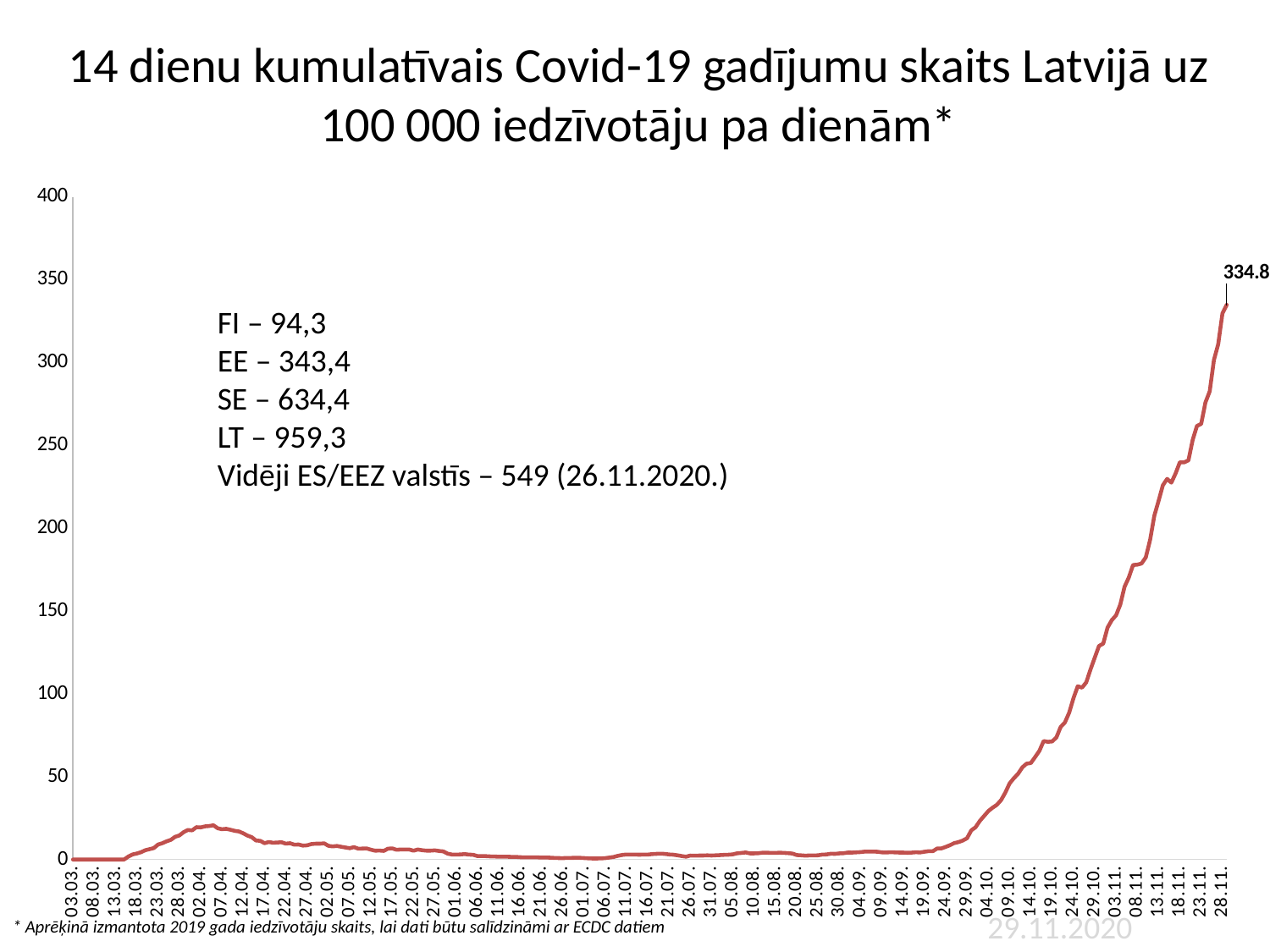
What kind of chart is shown on the slide? line chart Is the value on 01.07. greater or less than 50? less Does the line rise or fall between 29.09. and 28.11.? rises What is the title of the chart? 14 dienu kumulatīvais Covid-19 gadījumu skaits Latvijā uz 100 000 iedzīvotāju pa dienām* Is the value on 07.04. greater or less than 50? less Is the value on 28.11. greater or less than 300? greater What is the value shown by the data label at the end of the line (28.11.)? 334.8 Does the line rise or fall between 07.04. and 01.06.? falls What is the highest value shown on the vertical axis? 400